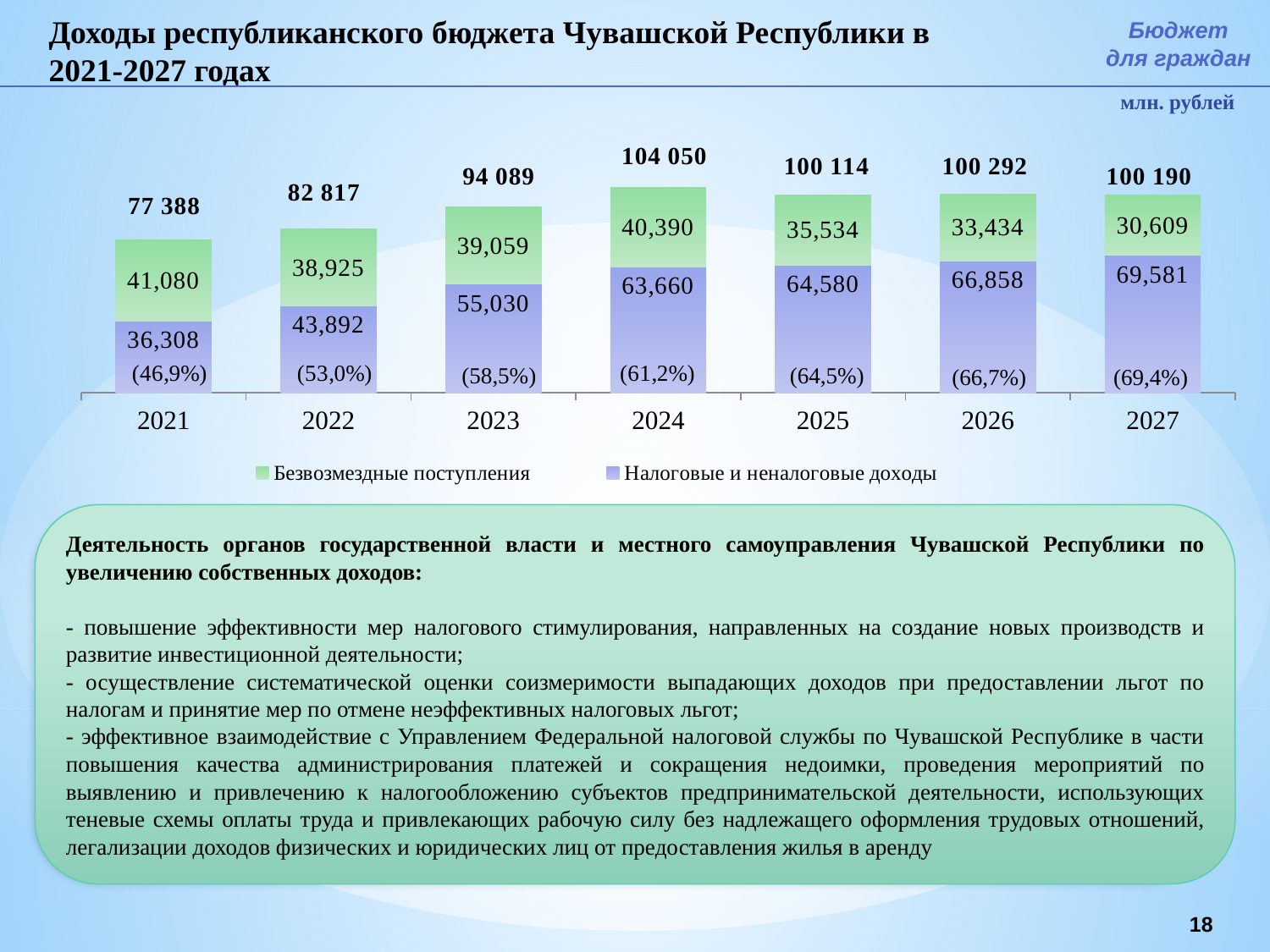
What is the difference between Налоговые и неналоговые доходы and Безвозмездные поступления in 2027? 38,972 Which year has the lowest value of Безвозмездные поступления? 2027 Which year has the highest total revenue? 2024 What is the value of Безвозмездные поступления for 2021? 41,080 What is the value of Налоговые и неналоговые доходы for 2024? 63,660 What percentage is shown in parentheses for 2026? (66,7%) Which year has the lowest total revenue? 2021 How many series does the chart legend list? 2 What is the total revenue shown above the bar for 2023? 94 089 How many years are shown on the x axis of the chart? 7 Which is larger in 2022: Безвозмездные поступления or Налоговые и неналоговые доходы? Налоговые и неналоговые доходы Do the values of Налоговые и неналоговые доходы rise or fall from 2021 to 2027? rise